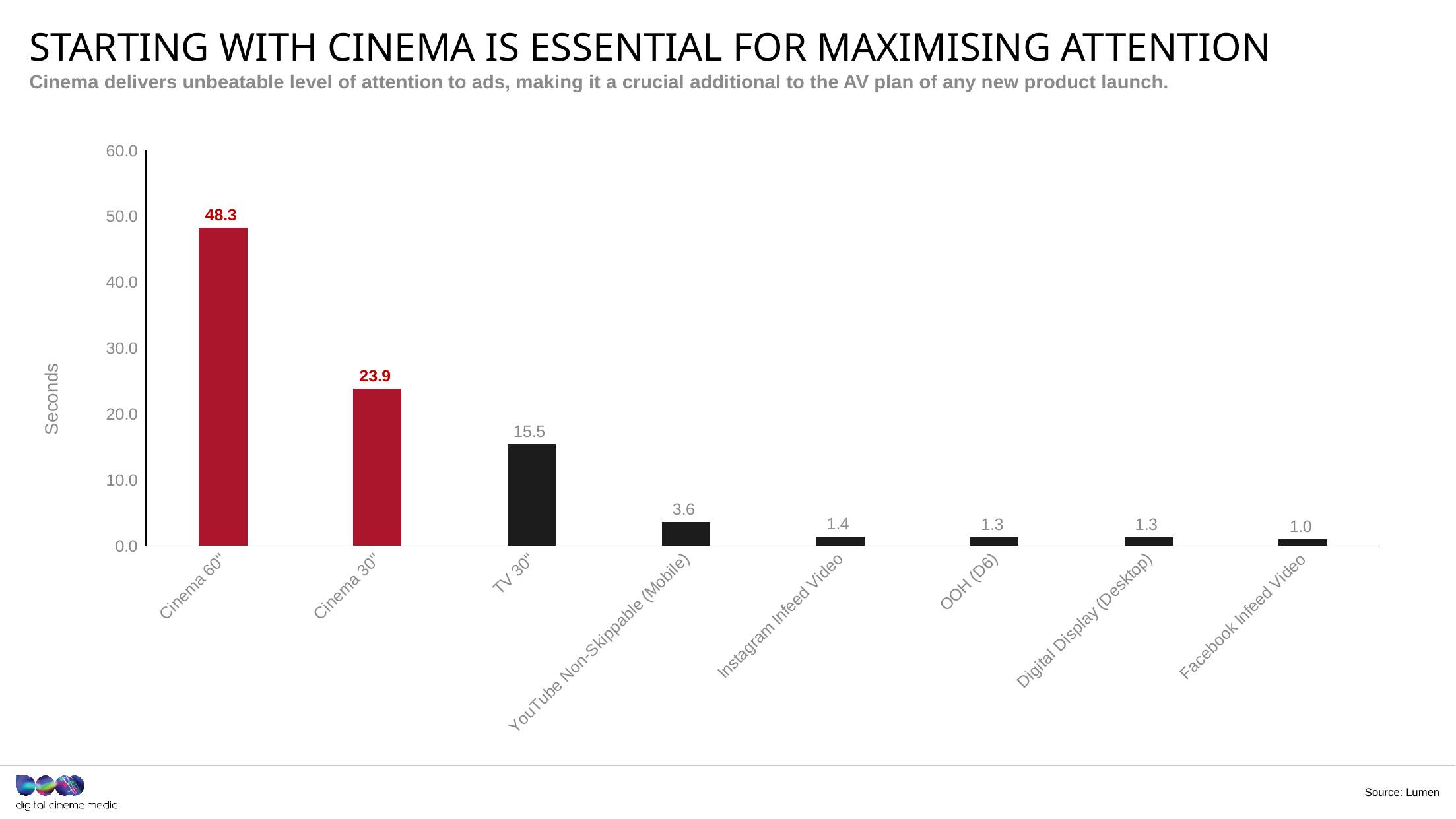
What is the difference between the values for Cinema 60" and Cinema 30"? 24.4 What kind of chart is shown on the slide? bar chart Which category has the lowest value? Facebook Infeed Video What is the value for YouTube Non-Skippable (Mobile)? 3.6 What is the value for TV 30"? 15.5 Which is larger, the value for Cinema 30" or the value for TV 30"? Cinema 30" What is the label of the vertical axis? Seconds What is the value for Cinema 60"? 48.3 How many categories are shown on the x axis? 8 Is the value for Cinema 60" greater or less than 40.0? greater What is the value for Facebook Infeed Video? 1.0 Which category has the highest value? Cinema 60"